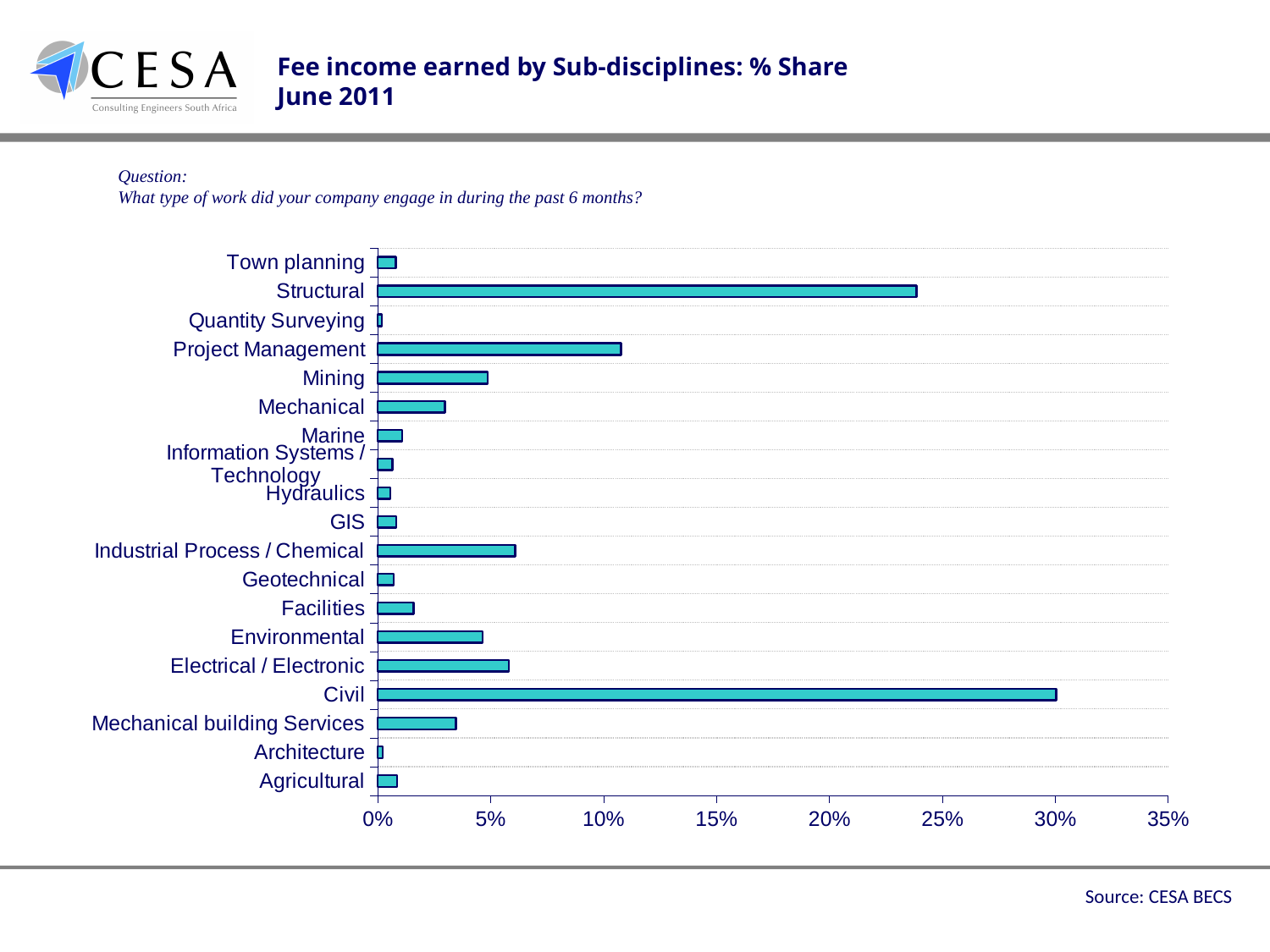
What is the highest value shown on the horizontal axis? 35% Is the value for Civil greater or less than 25%? greater Which has a larger fee income share, Mining or Mechanical? Mining Is the value for Mechanical greater or less than 5%? less Is the value for Structural greater or less than 20%? greater Which sub-discipline has the highest fee income share? Civil Which has a larger fee income share, Structural or Project Management? Structural How many sub-disciplines are listed on the chart? 19 What is the title of the chart on the slide? Fee income earned by Sub-disciplines: % Share June 2011 What kind of chart is shown on the slide? bar chart